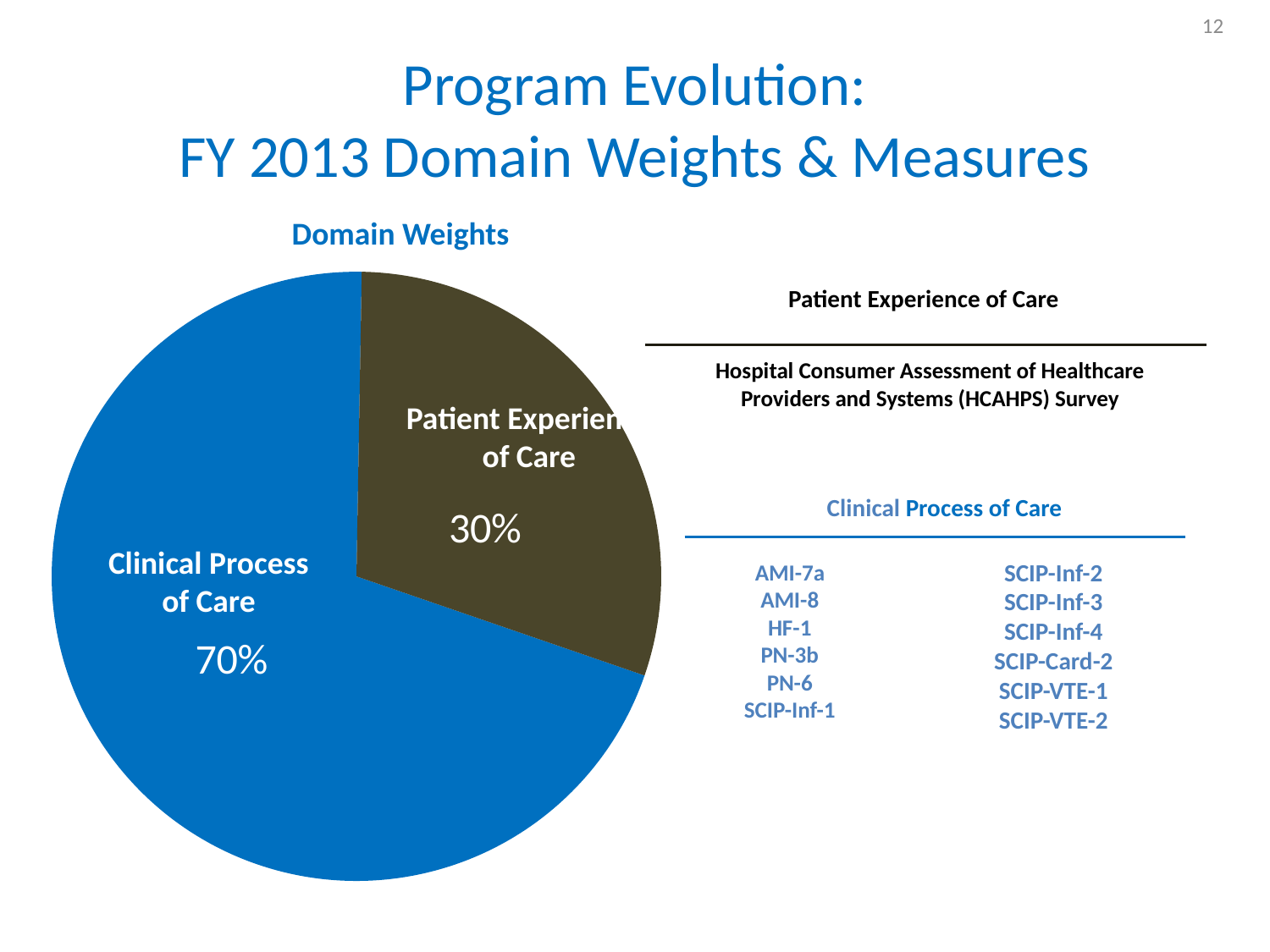
What is the value for Patient Experience of Care in the Domain Weights pie chart? 30% What is the title of the pie chart on the slide? Domain Weights What kind of chart is shown under the title "Domain Weights"? pie chart What colour is the Clinical Process of Care slice in the Domain Weights pie chart? blue What is the difference between the Clinical Process of Care and Patient Experience of Care weights in the Domain Weights pie chart? 40% What share of the Domain Weights pie does Patient Experience of Care represent? 30% How many slices does the Domain Weights pie chart have? 2 Which slice of the Domain Weights pie chart is the largest? Clinical Process of Care What is the value for Clinical Process of Care in the Domain Weights pie chart? 70% Which slice of the Domain Weights pie chart is the smallest? Patient Experience of Care Which is larger in the Domain Weights pie chart, Clinical Process of Care or Patient Experience of Care? Clinical Process of Care